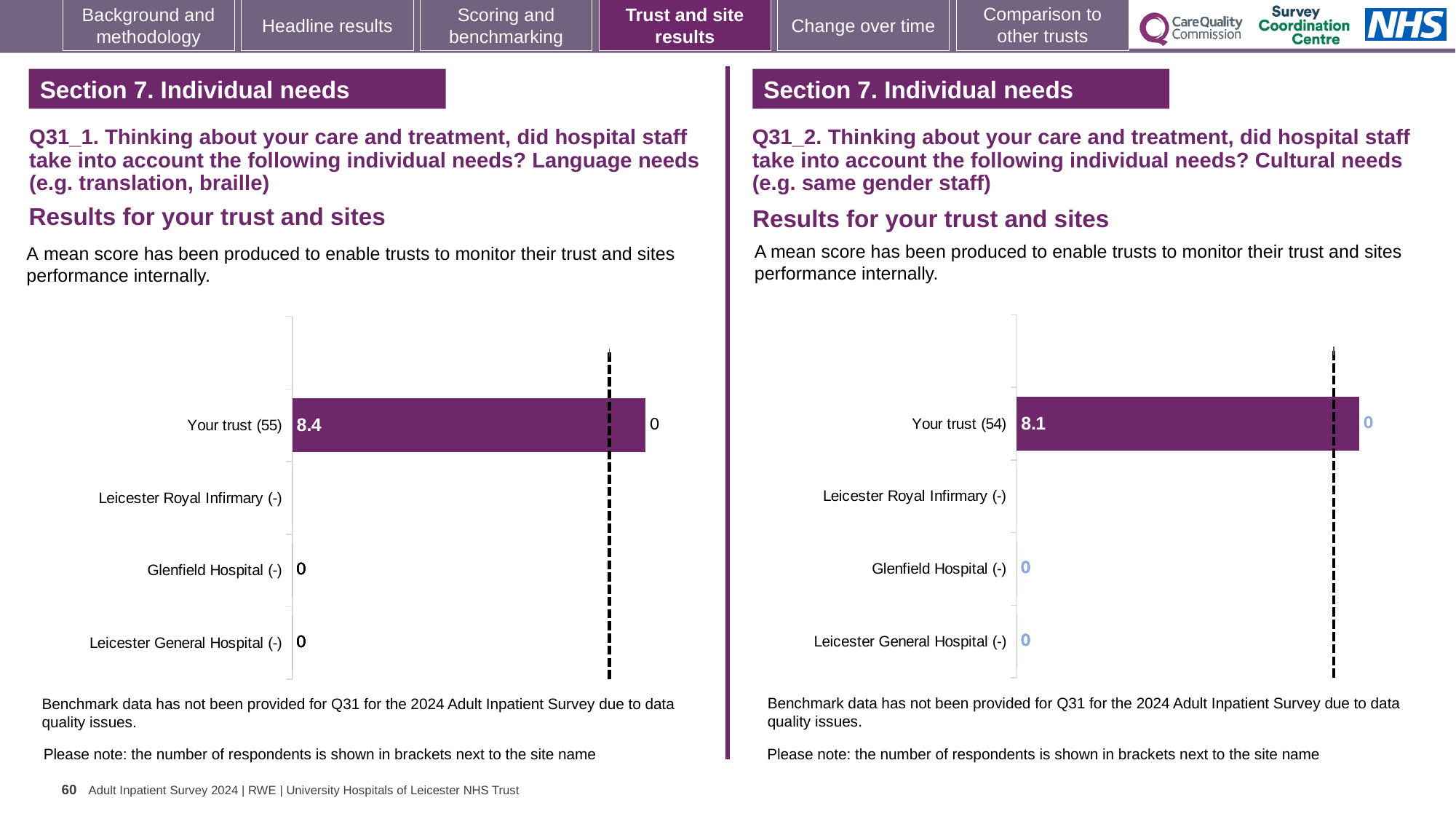
In the right chart (Q31_2, Cultural needs), how many respondents are shown in brackets for Your trust? 54 Which is larger: the Your trust score in the left chart (Q31_1) or the Your trust score in the right chart (Q31_2)? Left chart (Q31_1), 8.4 What is the difference between the Your trust score in the left chart (Q31_1) and the Your trust score in the right chart (Q31_2)? 0.3 How many categories are listed on the y axis of the left chart (Q31_1, Language needs)? 4 In the left chart (Q31_1, Language needs), what is the mean score for Your trust? 8.4 In the left chart (Q31_1, Language needs), how many respondents are shown in brackets for Your trust? 55 In the left chart (Q31_1, Language needs), which category has the highest score? Your trust (55) In the right chart (Q31_2, Cultural needs), what value is shown for Leicester General Hospital? 0 What kind of chart is used in the right chart (Q31_2, Cultural needs)? Bar chart In the right chart (Q31_2, Cultural needs), which category has the highest score? Your trust (54) In the left chart (Q31_1, Language needs), what value is shown for Glenfield Hospital? 0 In the right chart (Q31_2, Cultural needs), what is the mean score for Your trust? 8.1